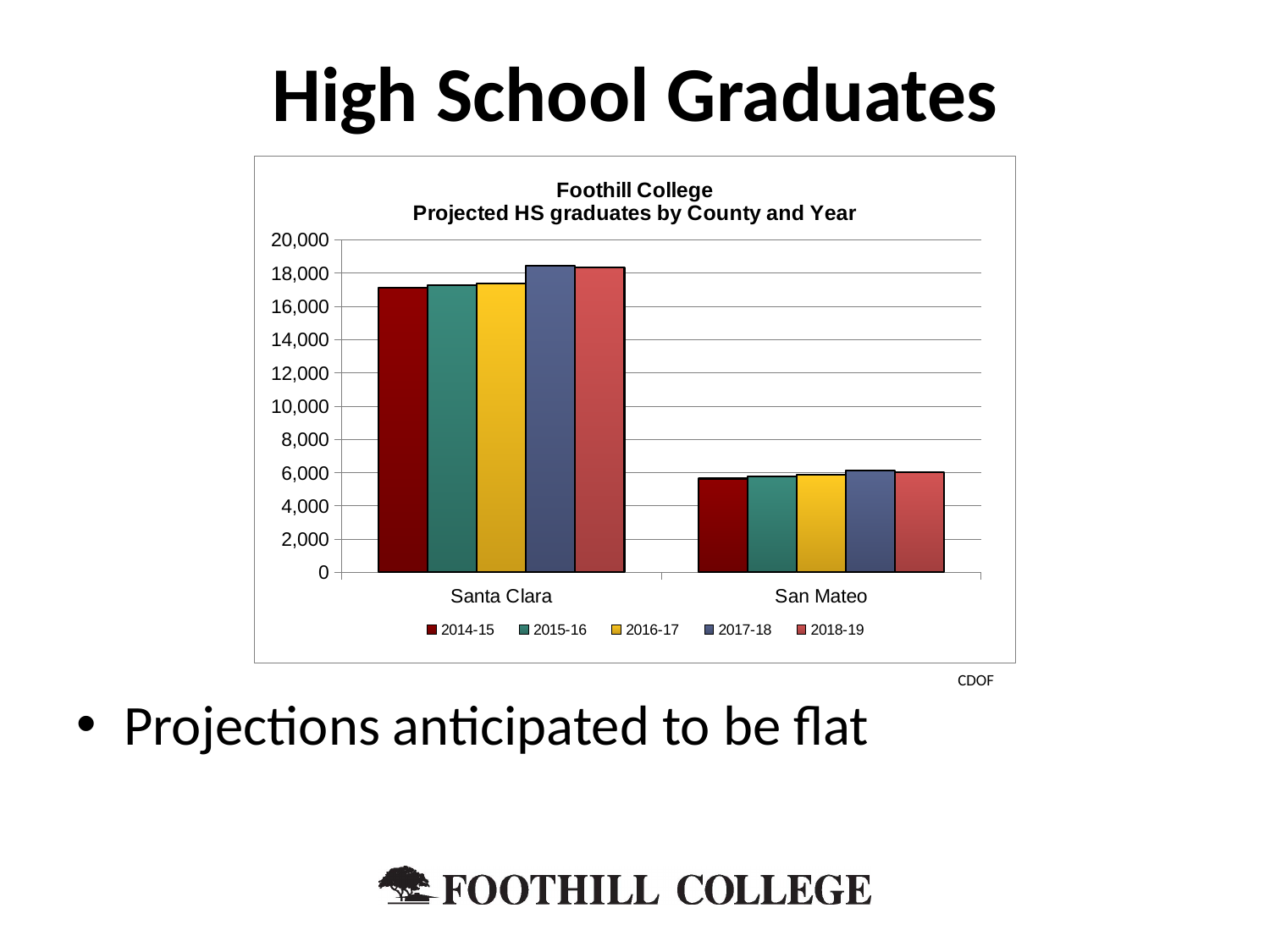
Is the value for Santa Clara in 2014-15 greater or less than 16,000? greater Is the value for San Mateo in 2014-15 greater or less than 6,000? less Which series is listed first in the chart's legend? 2014-15 Which county has the larger value for 2018-19, Santa Clara or San Mateo? Santa Clara What kind of chart is shown on the slide? bar chart What is the title of the chart? Foothill College Projected HS graduates by County and Year How many counties (categories) are shown on the x axis of the chart? 2 Is the value for San Mateo in 2014-15 greater or less than 4,000? greater How many series does the chart's legend list? 5